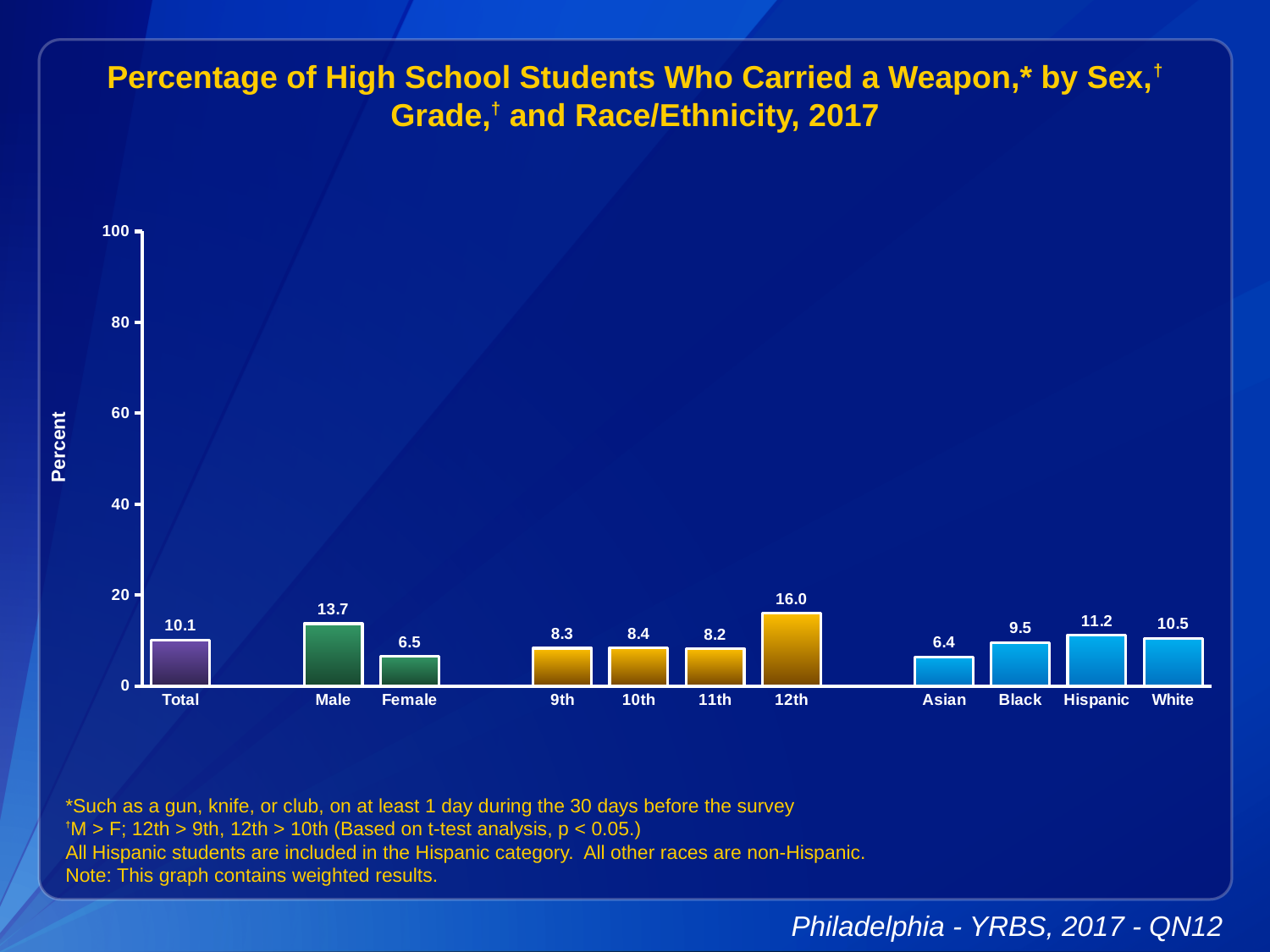
How many categories are shown on the x axis? 11 What kind of chart is this? bar chart Which category has the highest value? 12th Which is larger, the value for Black or the value for White? White What is the label of the y axis? Percent Is the value for 12th grade greater or less than 20? less What is the value for Hispanic students? 11.2 What is the value for Female? 6.5 What is the value for Total? 10.1 What is the difference between the Male and Female values? 7.2 Which category has the lowest value? Asian What is the value for 12th grade? 16.0